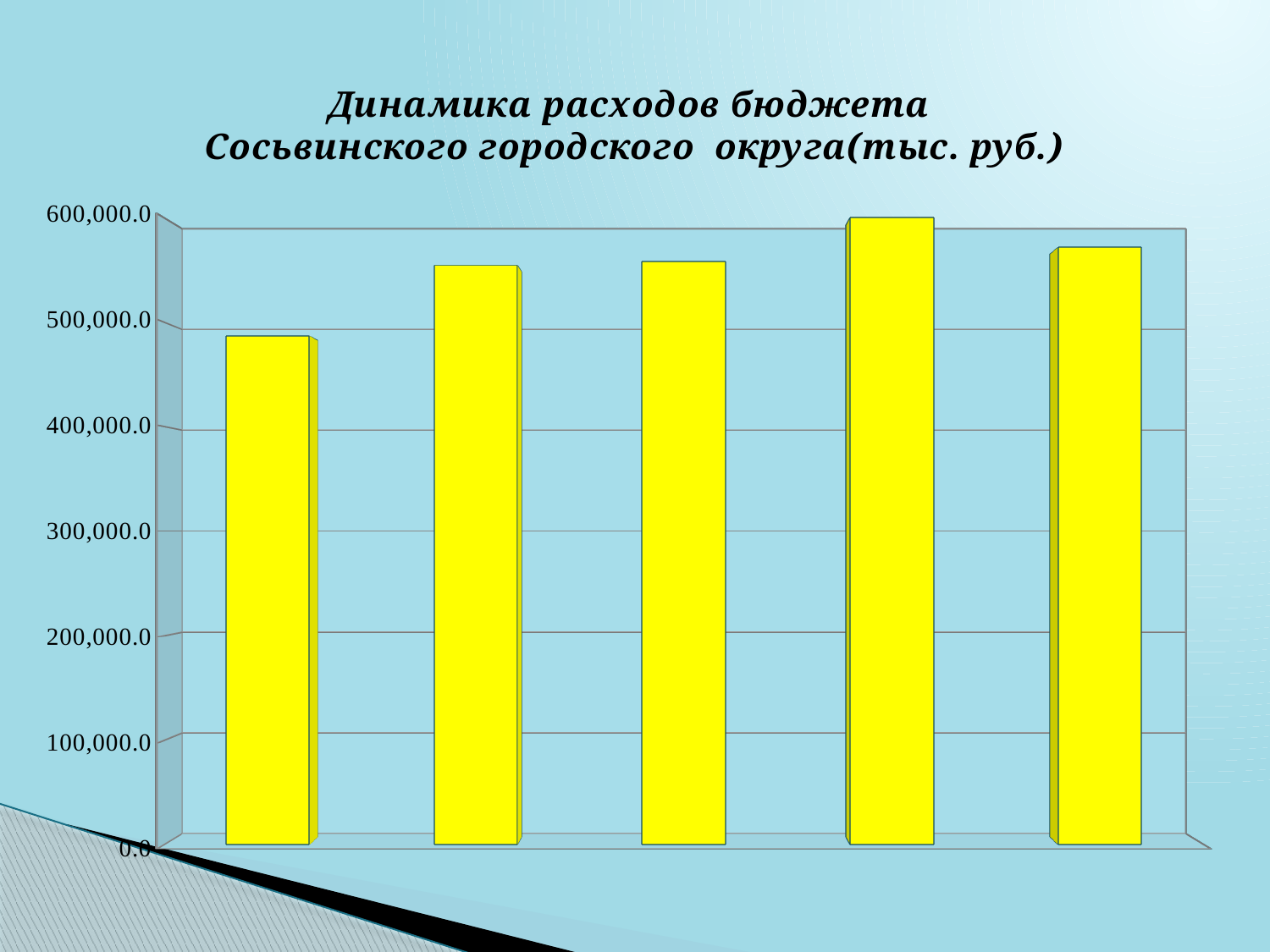
What kind of chart is shown on the slide? bar chart Is the value of the second bar greater or less than 600,000.0? less Is the value of the first bar greater or less than 400,000.0? greater Which bar is the shortest in the chart? the first bar Which is larger, the first bar or the second bar? the second bar What colour are the bars in the chart? yellow What is the title of the chart? Динамика расходов бюджета Сосьвинского городского округа(тыс. руб.) Which bar is the tallest in the chart? the fourth bar Is the value of the fourth bar greater or less than 500,000.0? greater Which is larger, the fourth bar or the fifth bar? the fourth bar How many bars are plotted in the chart? 5